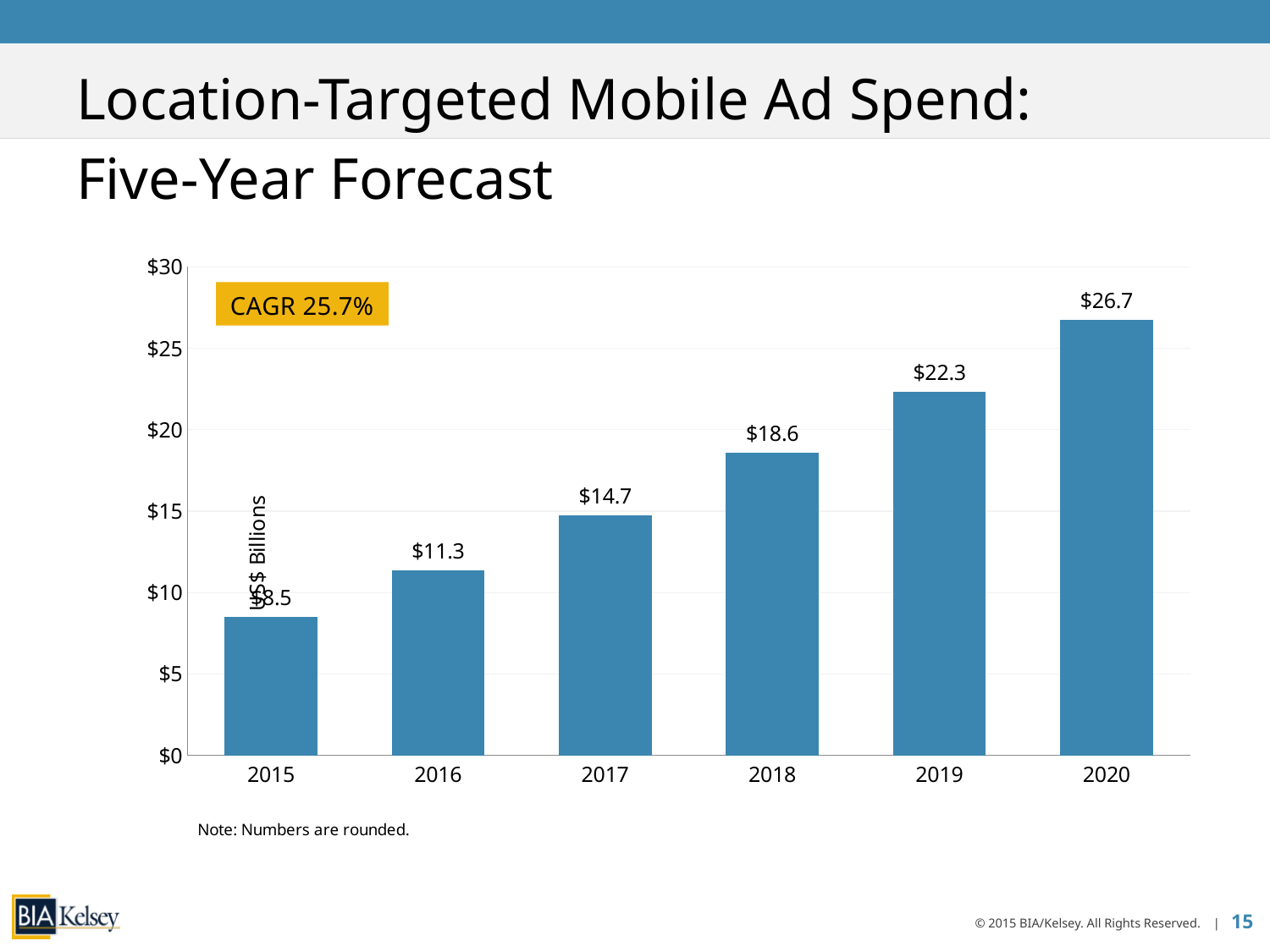
What is the value for 2019? $22.3 What kind of chart is this? bar chart What is the difference between the values for 2020 and 2019? $4.4 Which is larger, the value for 2017 or the value for 2018? 2018 What is the value for 2020? $26.7 Do the values rise or fall from 2015 to 2020? rise What is the difference between the values for 2018 and 2016? $7.3 What is the value for 2017? $14.7 Which year has the highest value? 2020 Which year has the lowest value? 2015 Is the value for 2015 greater or less than $10? less How many years are shown on the x axis? 6